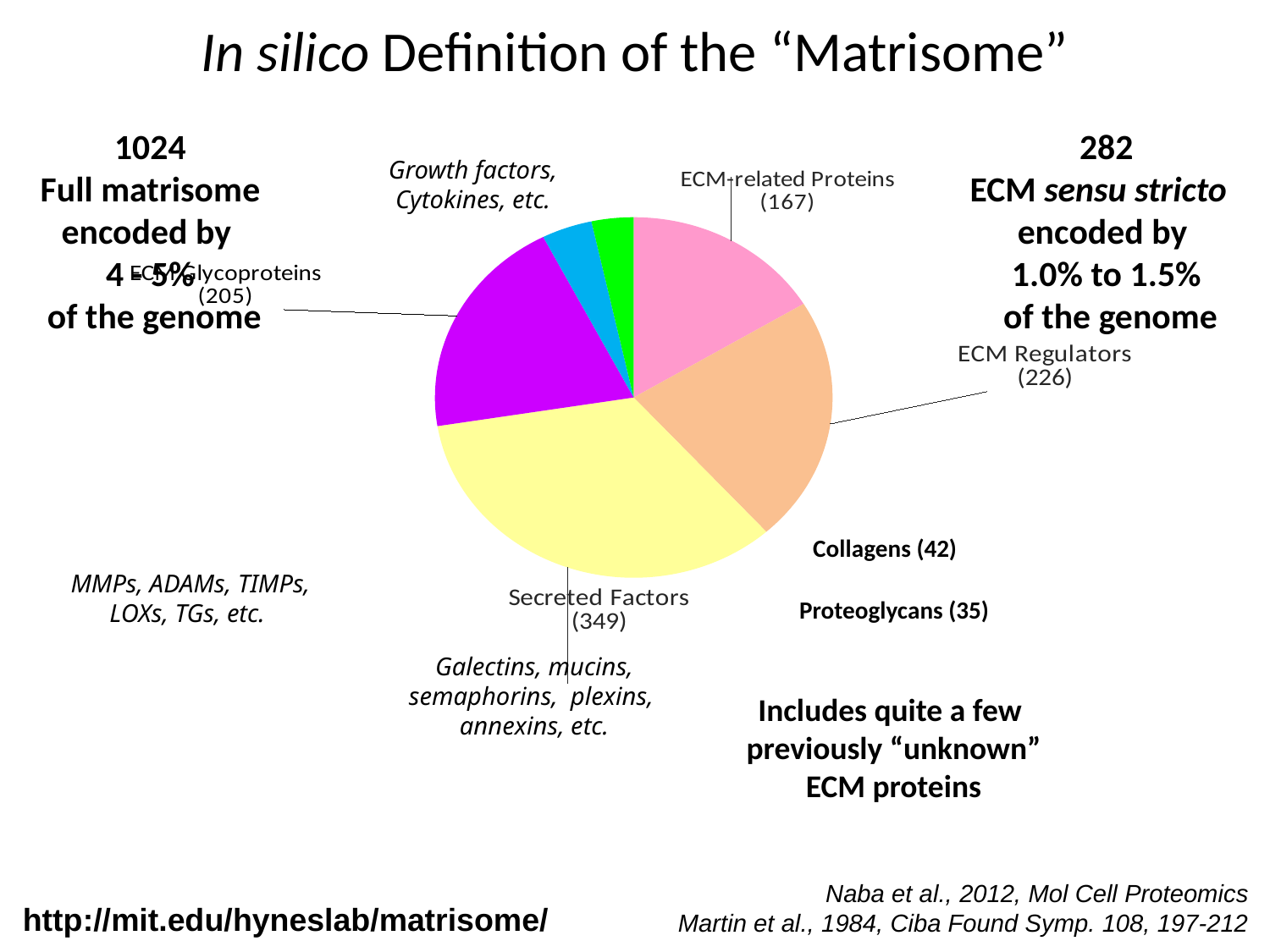
What is the difference between the values for Secreted Factors and ECM Regulators? 123 What is the value shown for ECM Regulators? 226 Which category has the smallest value in the pie chart? Proteoglycans Which is larger, the value for ECM Glycoproteins or the value for ECM-related Proteins? ECM Glycoproteins What is the value shown for ECM-related Proteins? 167 What is the value shown for Secreted Factors? 349 How many categories (slices) does the pie chart have? 6 What is the value shown for ECM Glycoproteins? 205 Which category has the largest slice of the pie chart? Secreted Factors What colour is the Secreted Factors slice of the pie chart? yellow What is the value shown for Collagens? 42 What kind of chart is shown on the slide? pie chart